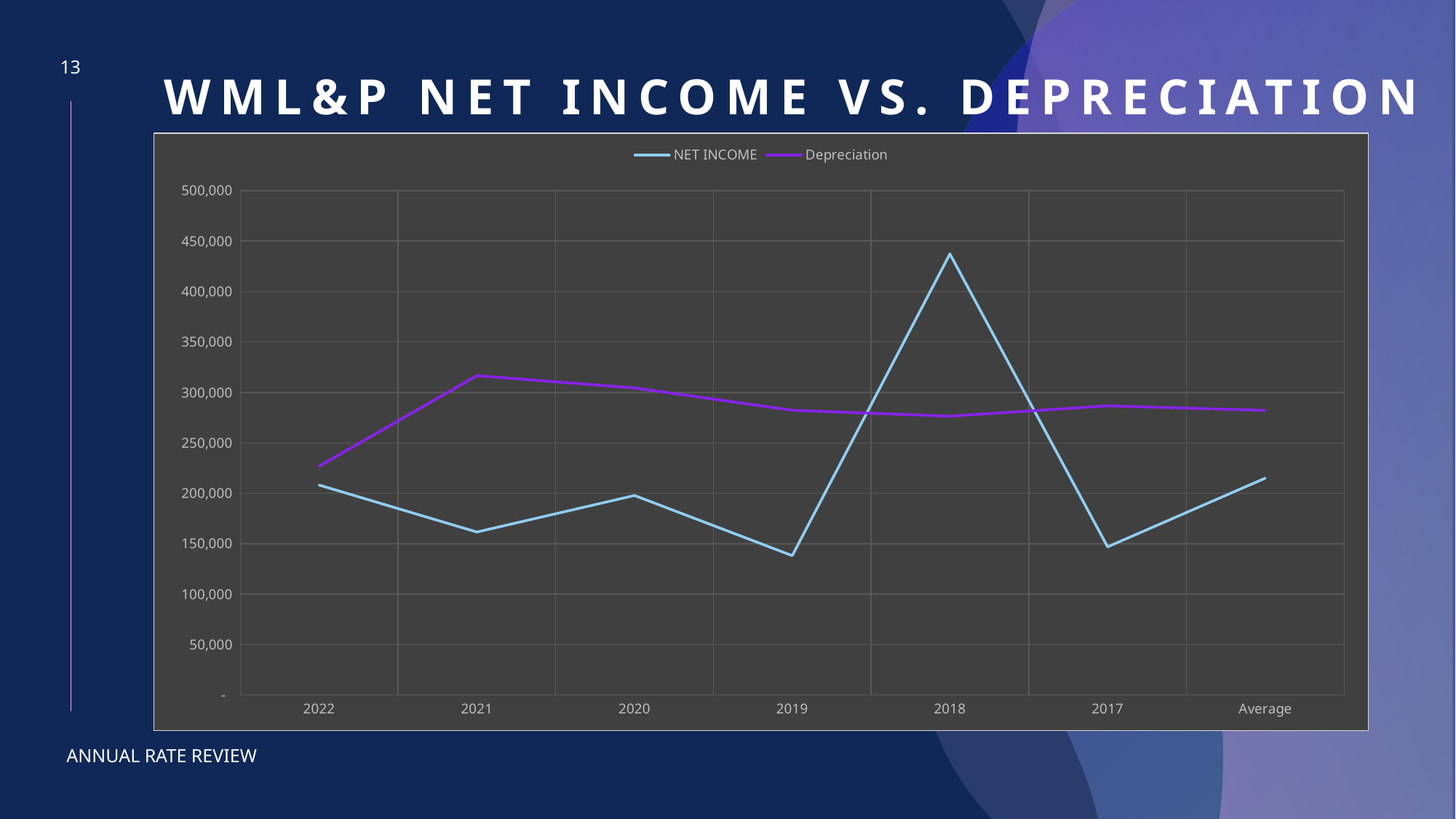
In which year is Depreciation highest? 2021 In which year is Depreciation lowest? 2022 Is the NET INCOME value for 2018 greater or less than 400,000? greater Which is larger in 2018, NET INCOME or Depreciation? NET INCOME How many series does the legend list? 2 How many categories are shown along the x axis? 7 What kind of chart is shown on the slide? line chart Is the NET INCOME value for 2019 greater or less than 150,000? less In which year is NET INCOME highest? 2018 Which is larger for the Average category, NET INCOME or Depreciation? Depreciation Is the Depreciation value for 2021 greater or less than 300,000? greater In which year is NET INCOME lowest? 2019